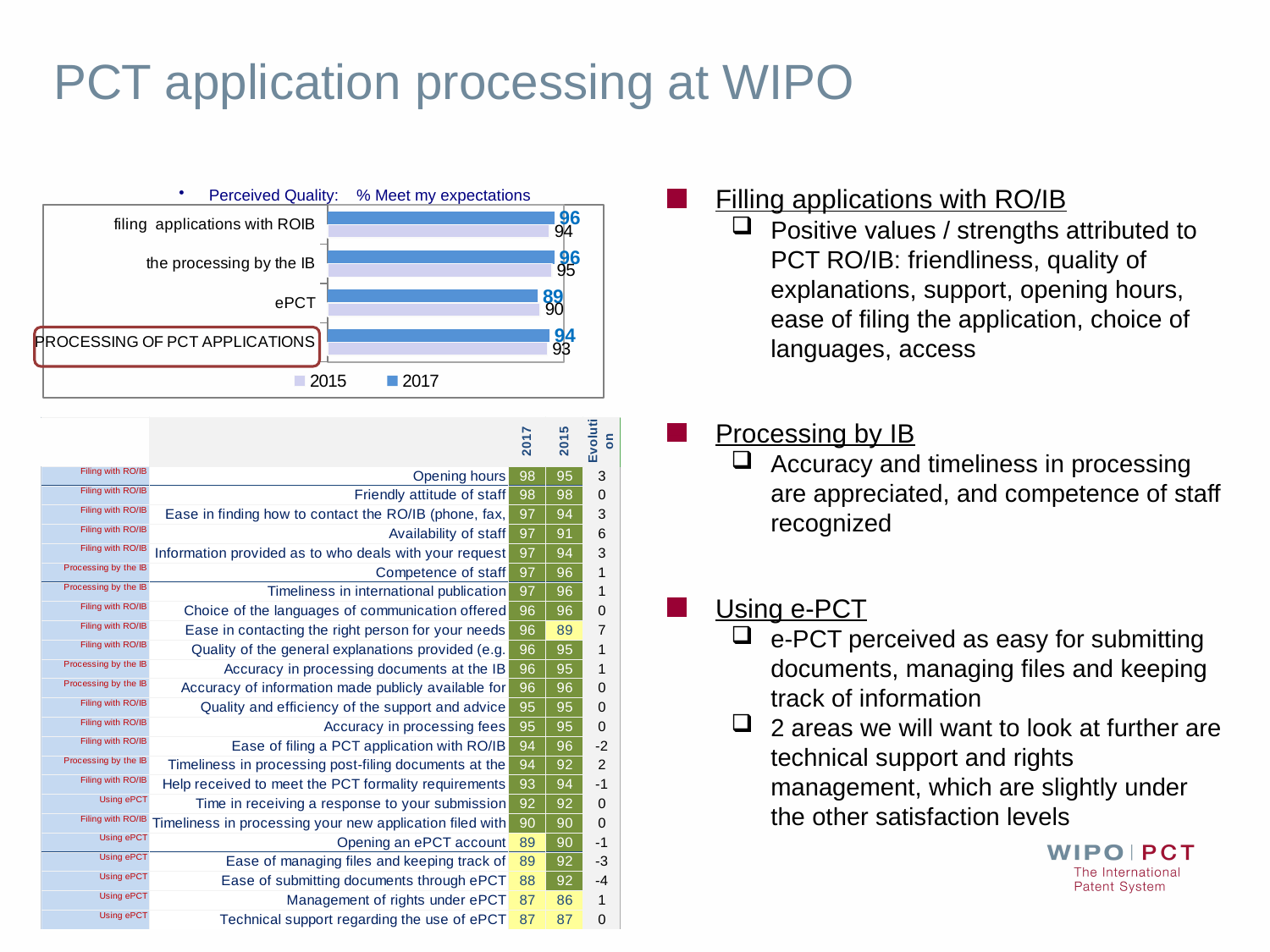
Which series is shown in dark blue in the Perceived Quality chart? 2017 Which category has the lowest 2015 value in the Perceived Quality chart? ePCT How many series does the legend of the Perceived Quality chart list? 2 How many categories are shown in the Perceived Quality chart? 4 In the Perceived Quality chart, what is the difference between the 2017 and 2015 values for 'filing applications with ROIB'? 2 What is the 2017 value for 'ePCT' in the Perceived Quality chart? 89 Which category has the lowest 2017 value in the Perceived Quality chart? ePCT What is the 2015 value for 'PROCESSING OF PCT APPLICATIONS' in the Perceived Quality chart? 93 What is the 2015 value for 'the processing by the IB' in the Perceived Quality chart? 95 What type of chart is the Perceived Quality chart? bar chart What is the 2017 value for 'filing applications with ROIB' in the Perceived Quality chart? 96 In the Perceived Quality chart, is the 2017 value for 'ePCT' larger or smaller than its 2015 value? smaller